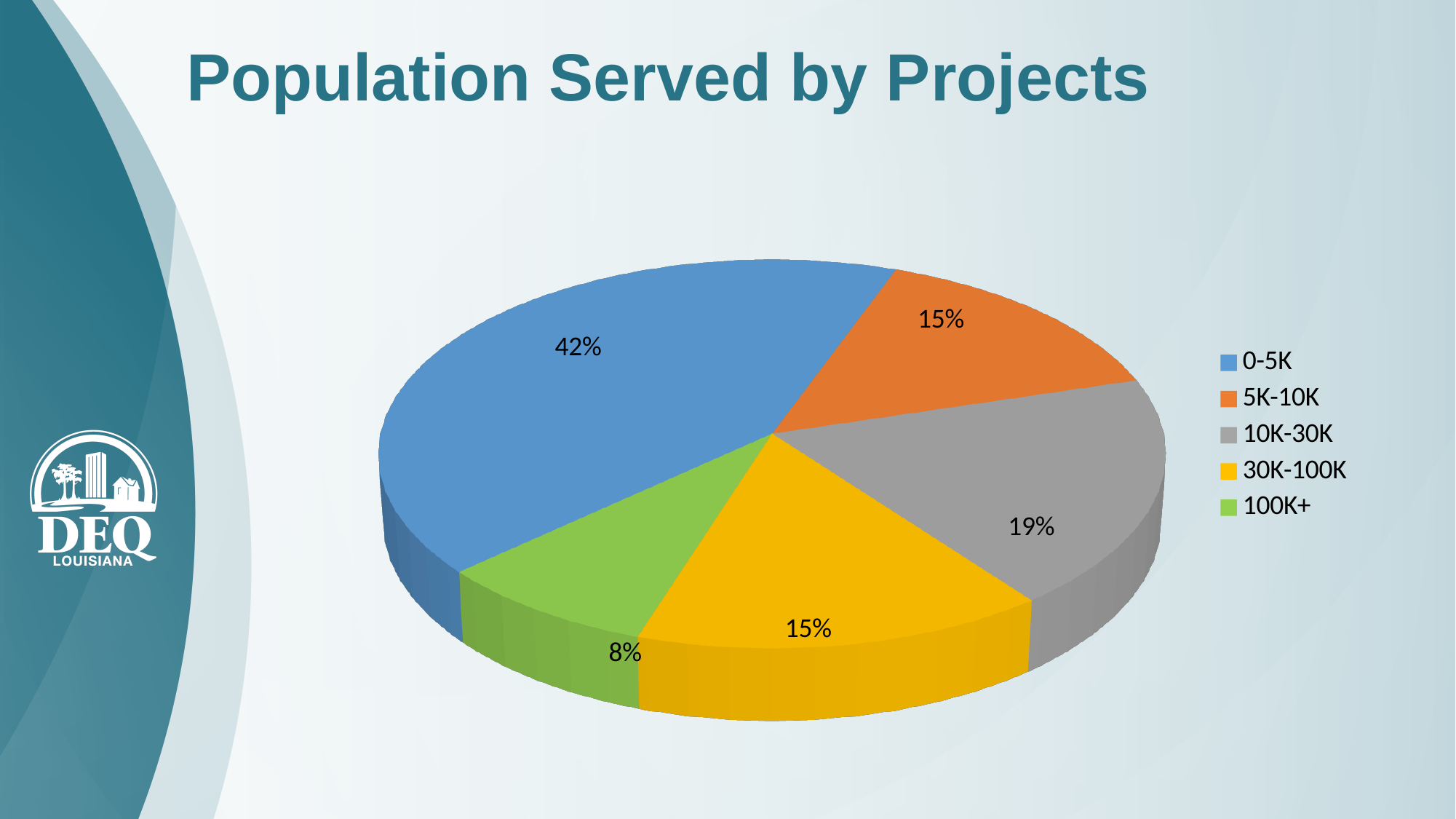
What share of the pie does the 0-5K category represent? 42% Which category has the smallest share of the pie? 100K+ What is the value shown for the 5K-10K slice? 15% What share of the pie does the 10K-30K category represent? 19% What is the difference in percentage points between the 0-5K slice and the 10K-30K slice? 23 What share of the pie does the 100K+ category represent? 8% Which is larger, the share for 10K-30K or the share for 100K+? 10K-30K What is the value shown for the 30K-100K slice? 15% What is the title of the chart? Population Served by Projects How many categories does the legend list? 5 Which category has the largest share of the pie? 0-5K What type of chart is shown on the slide? pie chart